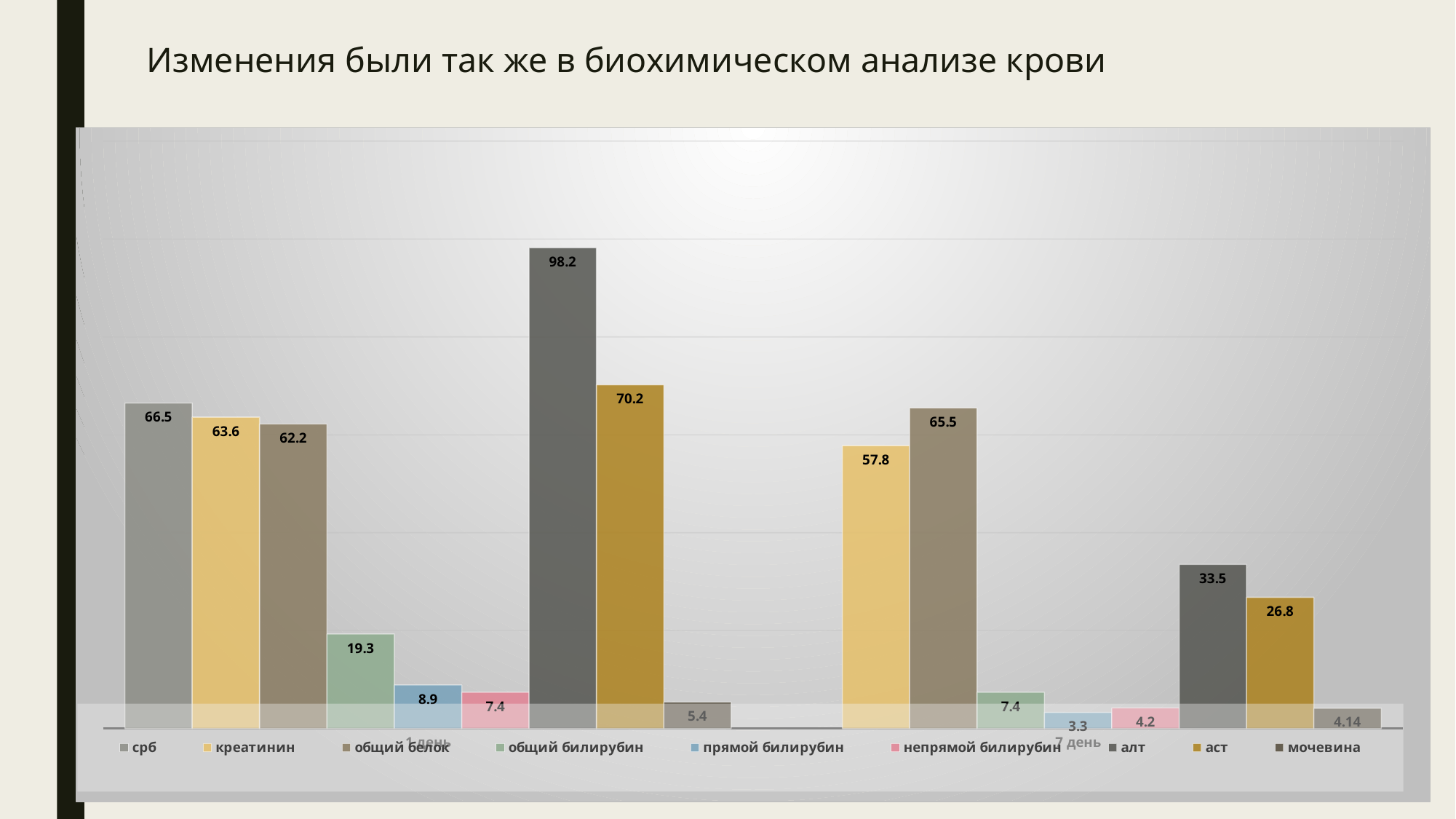
Which series has the highest value on 1 день? алт What is the value of мочевина on 7 день? 4.14 Which series has the lowest value on 7 день among the bars with labels? прямой билирубин What is the difference between the алт values on 1 день and 7 день? 64.7 Does the value of общий белок rise or fall from 1 день to 7 день? rise Which is larger: аст on 1 день or аст on 7 день? аст on 1 день How many series does the legend list? 9 What is the title of the slide? Изменения были так же в биохимическом анализе крови What is the value of общий билирубин on 1 день? 19.3 What is the value of креатинин on 7 день? 57.8 What type of chart is shown on the slide? bar chart What is the value of алт on 1 день? 98.2